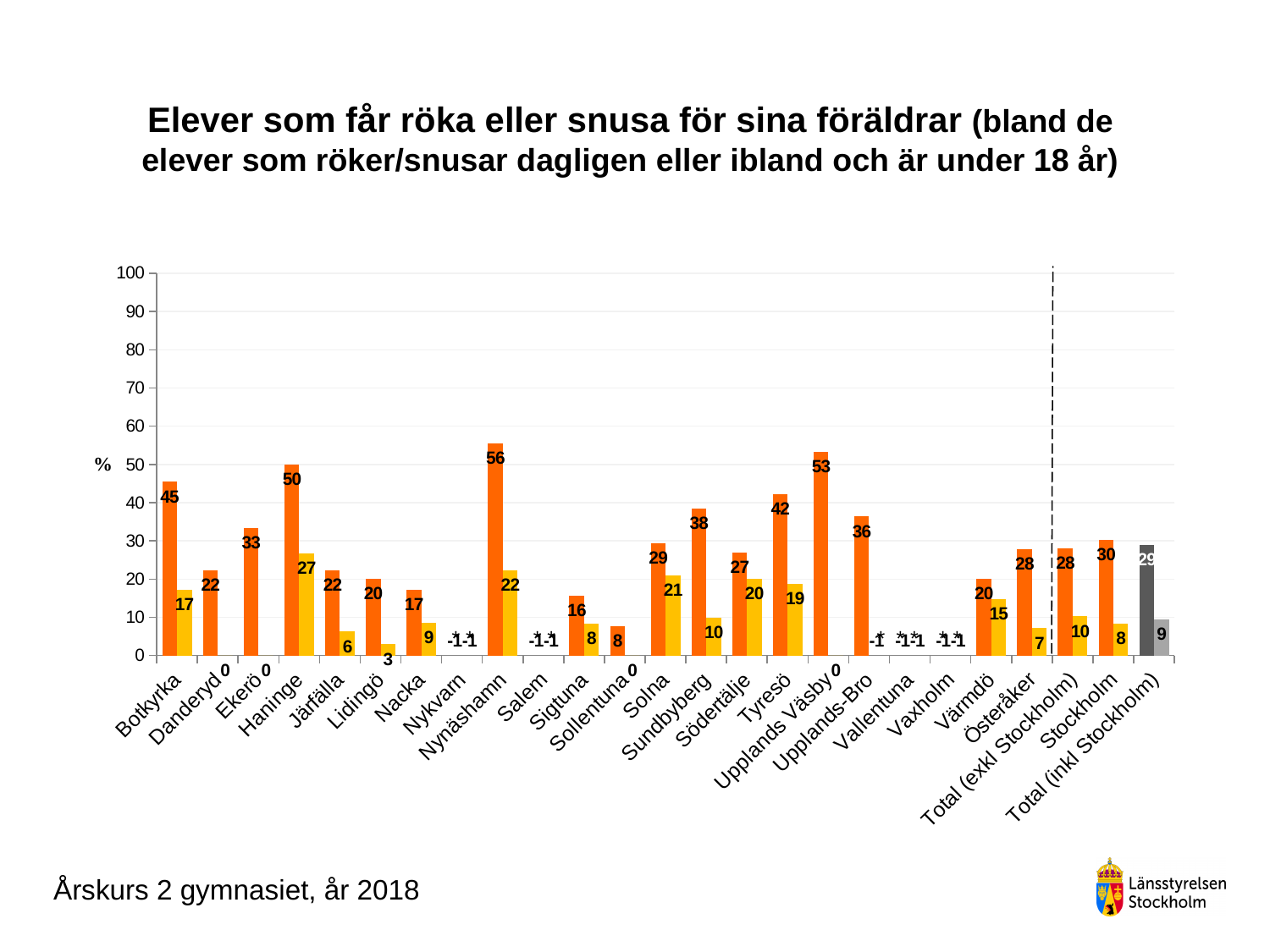
What is the difference between the orange bar for Botkyrka (45) and the yellow bar for Botkyrka (17)? 28 Which is larger, the orange bar for Tyresö or the orange bar for Sundbyberg? Tyresö Is the orange bar for Haninge greater or less than 40? greater What is the difference between the orange bar for Stockholm (30) and the orange bar for Total (exkl Stockholm) (28)? 2 What kind of chart is shown on the slide? bar chart Which category has the highest yellow bar? Haninge What is the value of the orange bar for Upplands Väsby? 53 Which municipality has the highest orange bar? Nynäshamn What is the label on the vertical axis? % What is the value of the orange bar for Nynäshamn? 56 What is the value of the yellow bar for Haninge? 27